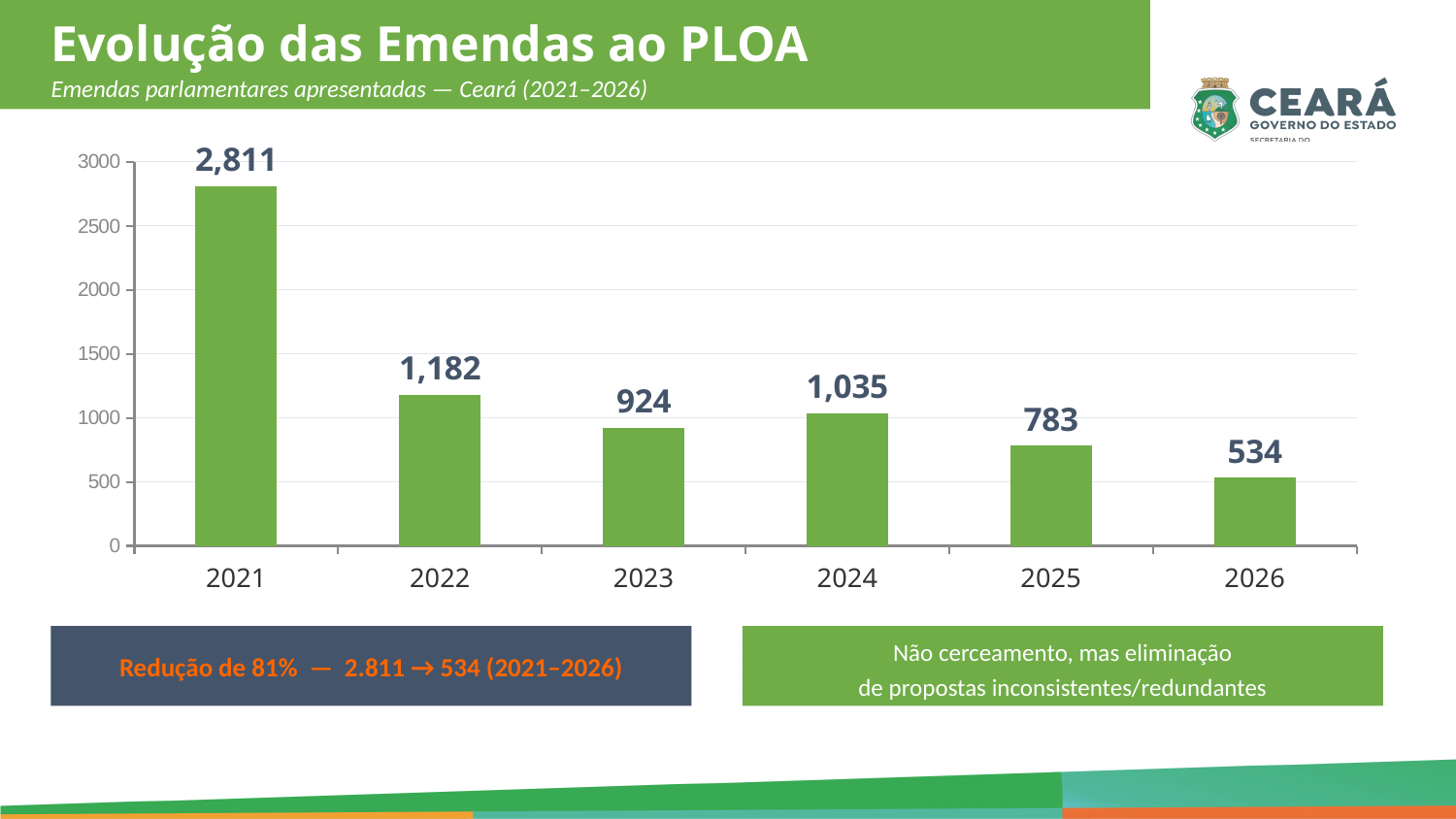
Which year has the lowest value? 2026 Is the value for 2025 greater or less than 1000? less What is the difference between the values for 2021 and 2022? 1,629 What is the value for 2024? 1,035 How many years are shown on the x axis? 6 Do the values generally rise or fall from 2021 to 2026? fall Which is larger, the value for 2023 or the value for 2024? 2024 Which year has the highest value? 2021 What is the value for 2026? 534 What is the value for 2021? 2,811 What kind of chart is shown on the slide? bar chart What is the difference between the values for 2024 and 2025? 252